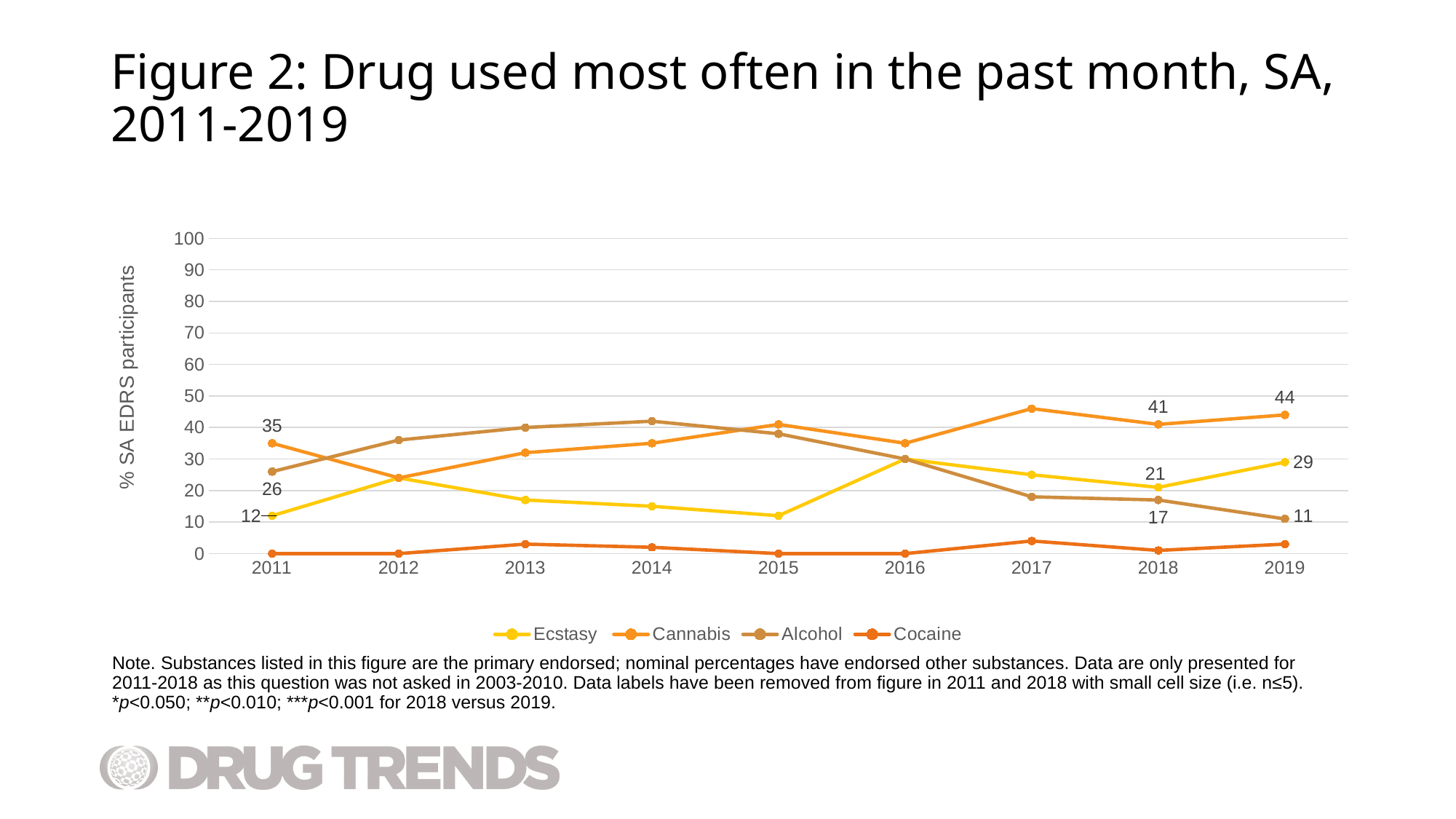
How many series does the legend list? 4 How many years are plotted along the x axis? 9 Which series has the highest value in 2019? Cannabis Is the value for Cannabis in 2017 greater or less than 40? greater What is the label on the y axis? % SA EDRS participants In 2019, which is larger: the value for Ecstasy or the value for Alcohol? Ecstasy Does the Alcohol line rise or fall from 2016 to 2019? fall What is the value for Alcohol in 2011? 26 By how much did the Cannabis value change from 2018 to 2019? 3 What is the value for Ecstasy in 2018? 21 What kind of chart is shown on the slide? line chart What is the value for Cannabis in 2019? 44